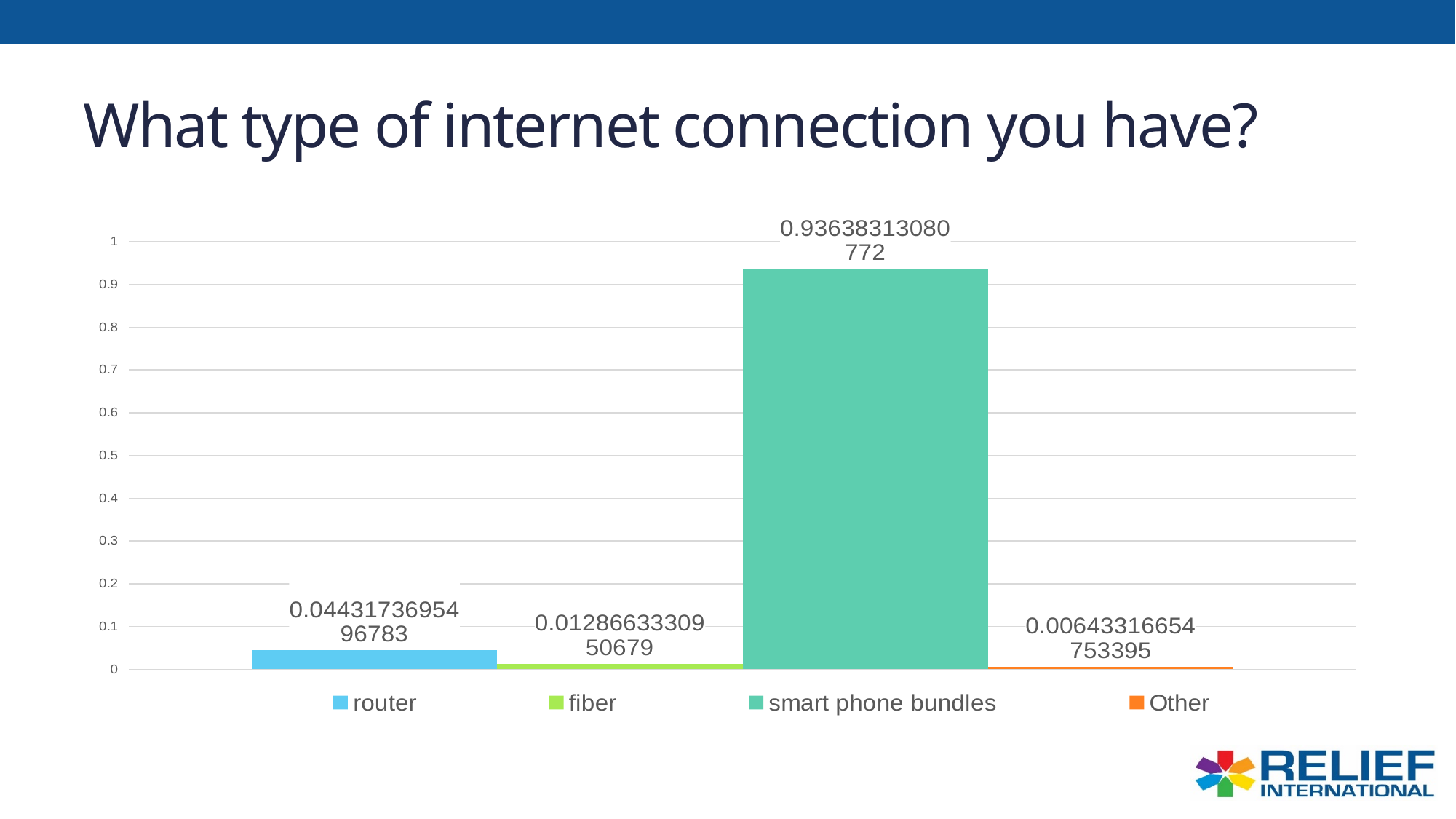
What is the value for fiber? 0.0128663330950679 Is the value for smart phone bundles greater or less than 0.9? greater Which is larger, the value for router or the value for fiber? router What is the value for router? 0.0443173695496783 Which type of internet connection has the highest value? smart phone bundles What is the title of the slide? What type of internet connection you have? Which type of internet connection has the lowest value? Other What is the value for smart phone bundles? 0.93638313080772 What is the value for Other? 0.00643316654753395 How many series does the legend list? 4 What kind of chart is shown on the slide? bar chart Is the value for router greater or less than 0.1? less